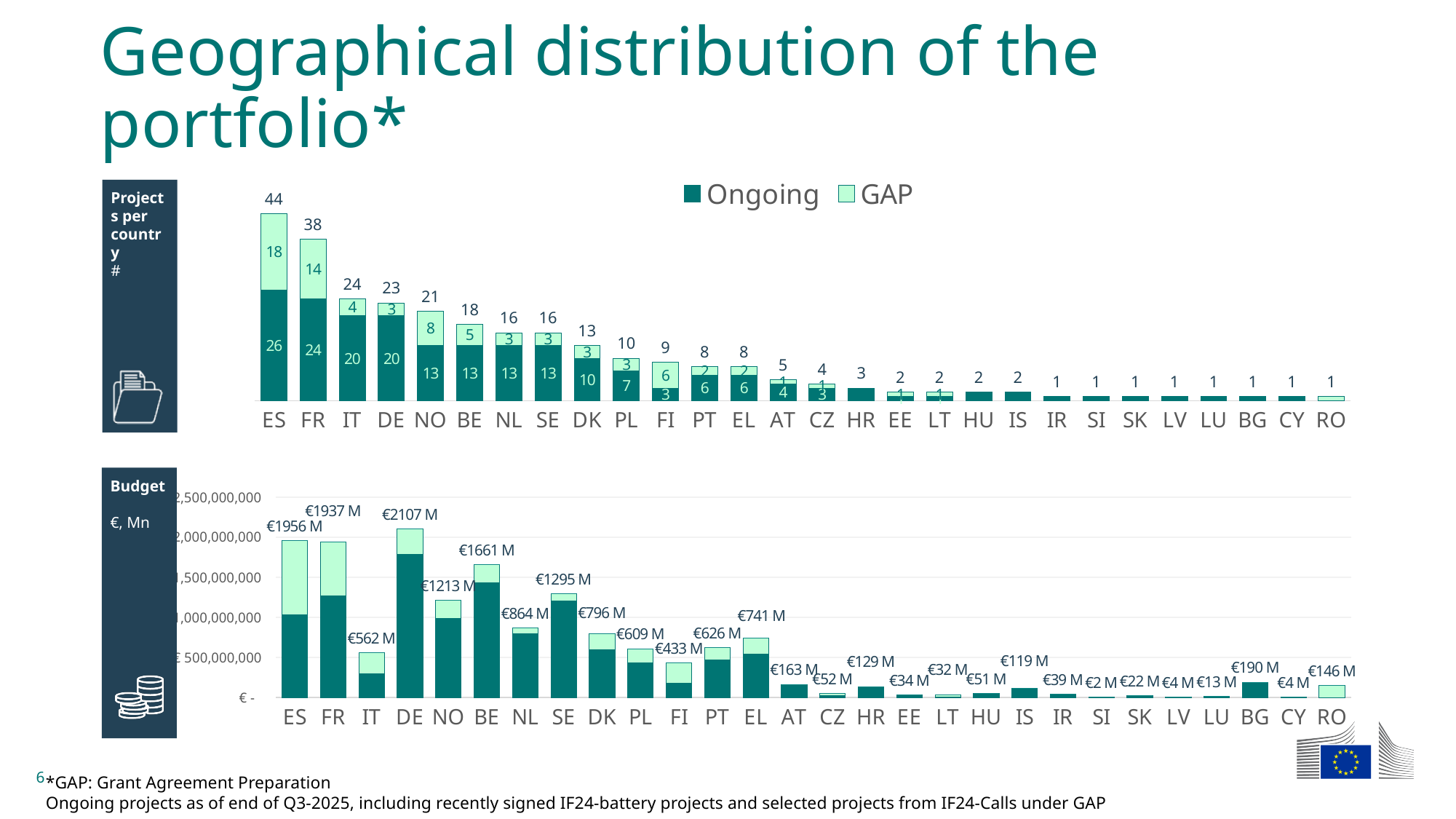
In the 'Budget' chart, is the total bar for IT greater or less than 1,000,000,000? less In the 'Projects per country' chart, how many Ongoing projects does ES have? 26 In the 'Projects per country' chart, what is the difference between the total projects of ES and FR? 6 In the 'Projects per country' chart, how many GAP projects does NO have? 8 What type of chart is the 'Budget' chart? Stacked bar chart In the 'Budget' chart, what is the budget for DE? €2107 M In the 'Projects per country' chart, what is the total number of projects for FR? 38 In the 'Projects per country' chart, which country has the highest total number of projects? ES In the 'Budget' chart, which country has the lowest budget? SI In the 'Projects per country' chart, which has more GAP projects, FI or PT? FI How many series does the legend list? 2 How many countries are shown in the 'Budget' chart? 28